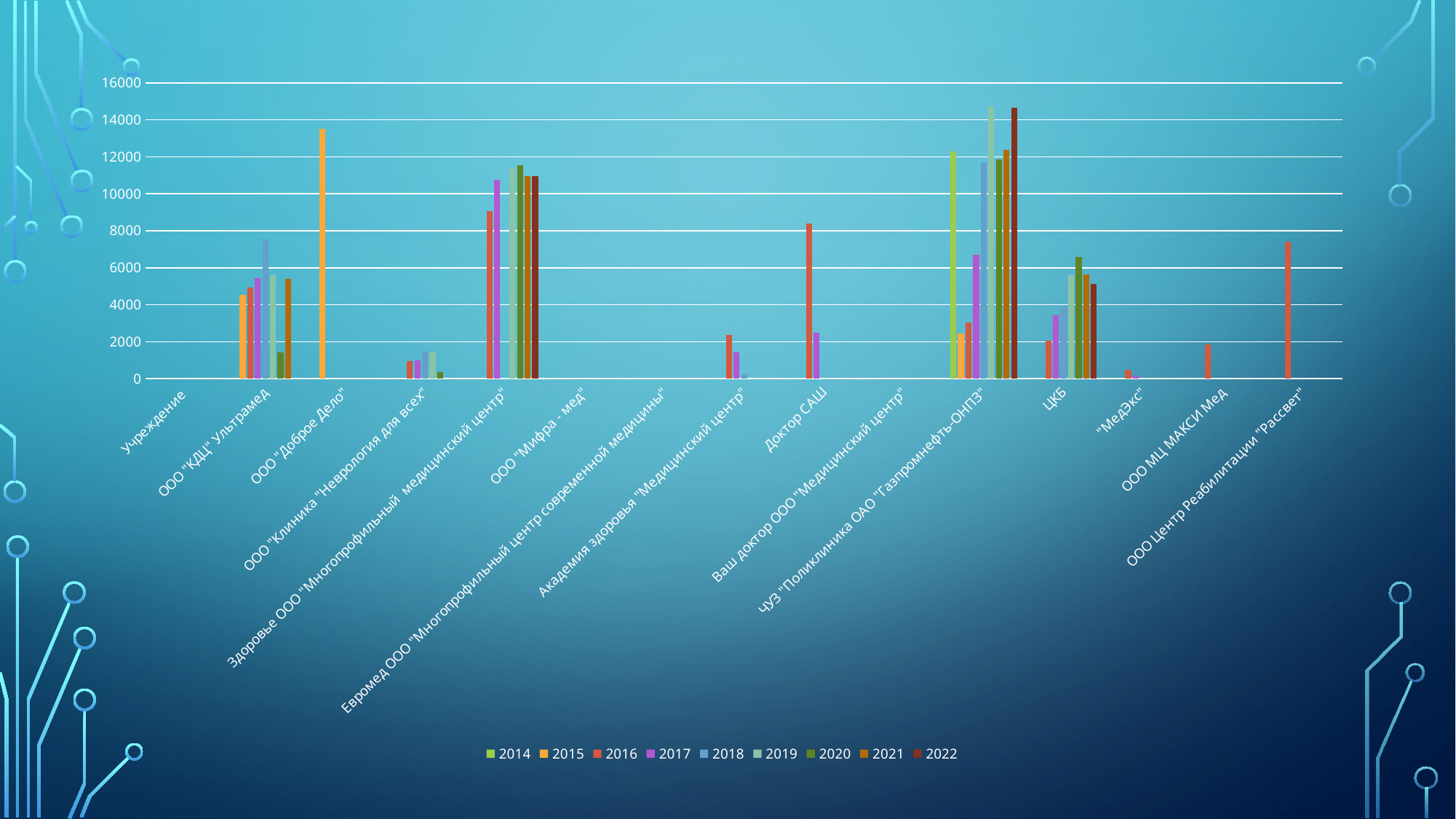
Is the 2015 value for ООО "Доброе Дело" greater or less than 12000? greater Is the 2018 value for ООО "КДЦ" Ультрамед greater or less than 8000? less Is the 2016 value for Доктор САШ greater or less than 8000? greater For ЦКБ, which year has the tallest bar? 2020 Which category has the tallest bar on the chart? ЧУЗ "Поликлиника ОАО "Газпромнефть-ОНПЗ" Which years does the legend cover? 2014 to 2022 How many series does the legend list? 9 How many categories are shown on the x axis? 15 What kind of chart is shown on the slide? bar chart Which is larger: the 2015 value for ООО "Доброе Дело" or the 2016 value for Доктор САШ? 2015 value for ООО "Доброе Дело"